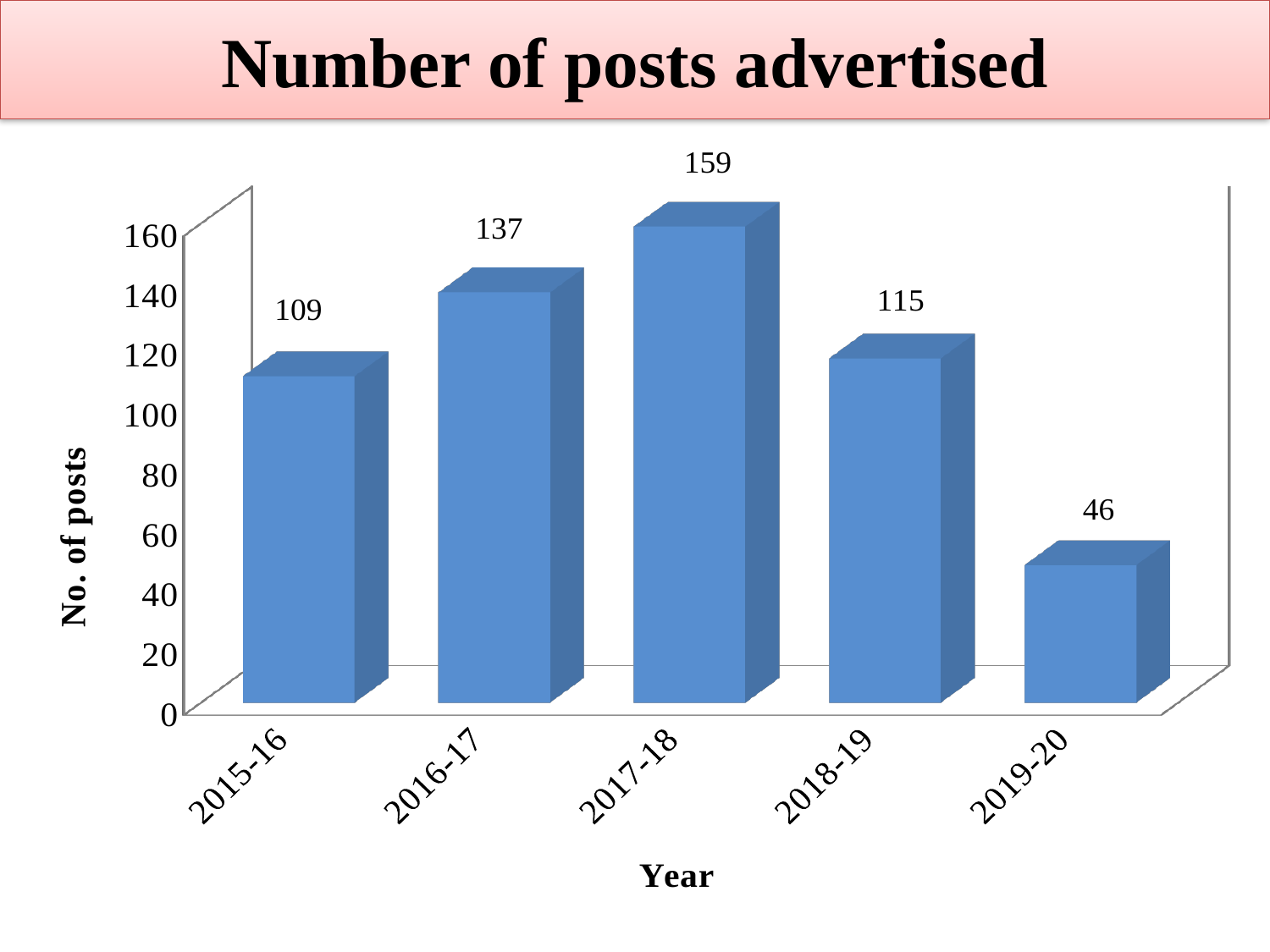
What kind of chart is shown on the slide? bar chart How many years are shown on the x axis? 5 What is the number of posts advertised for 2019-20? 46 How many more posts were advertised in 2016-17 than in 2015-16? 28 What is the label of the vertical axis? No. of posts Which year had more posts advertised, 2015-16 or 2018-19? 2018-19 Do the values rise or fall from 2017-18 to 2019-20? fall What is the difference between the number of posts advertised in 2017-18 and 2019-20? 113 Which year had the highest number of posts advertised? 2017-18 Which year had the lowest number of posts advertised? 2019-20 How many posts were advertised in 2017-18? 159 Is the value for 2016-17 greater or less than 120? greater